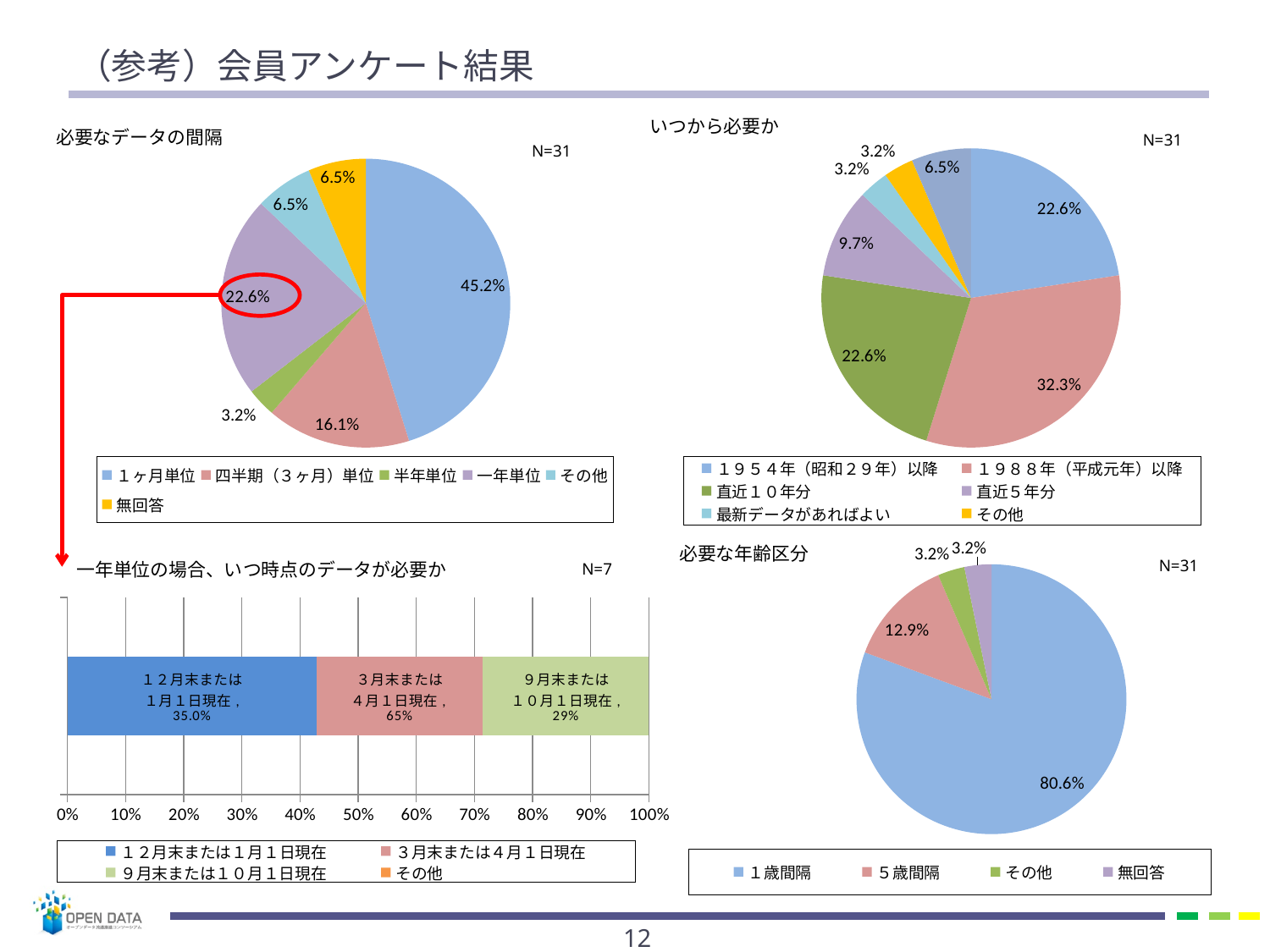
In the 必要な年齢区分 pie chart, what is the difference between the shares for 1歳間隔 and 5歳間隔? 67.7% What kind of chart is the 一年単位の場合、いつ時点のデータが必要か chart at the bottom left? bar chart In the いつから必要か pie chart, what share is shown for 直近5年分? 9.7% In the 必要なデータの間隔 pie chart, what is the difference between the shares for 1ヶ月単位 and 四半期（3ヶ月）単位? 29.1% In the 必要なデータの間隔 pie chart, which category has the largest share? 1ヶ月単位 In the いつから必要か pie chart, what share is shown for 1988年（平成元年）以降? 32.3% In the 必要なデータの間隔 pie chart, what share is shown for 1ヶ月単位? 45.2% In the いつから必要か pie chart, which is larger: the share for 1988年（平成元年）以降 or the share for 直近10年分? 1988年（平成元年）以降 How many entries does the legend of the 必要なデータの間隔 pie chart list? 6 What is the N value shown for the 一年単位の場合、いつ時点のデータが必要か chart? N=7